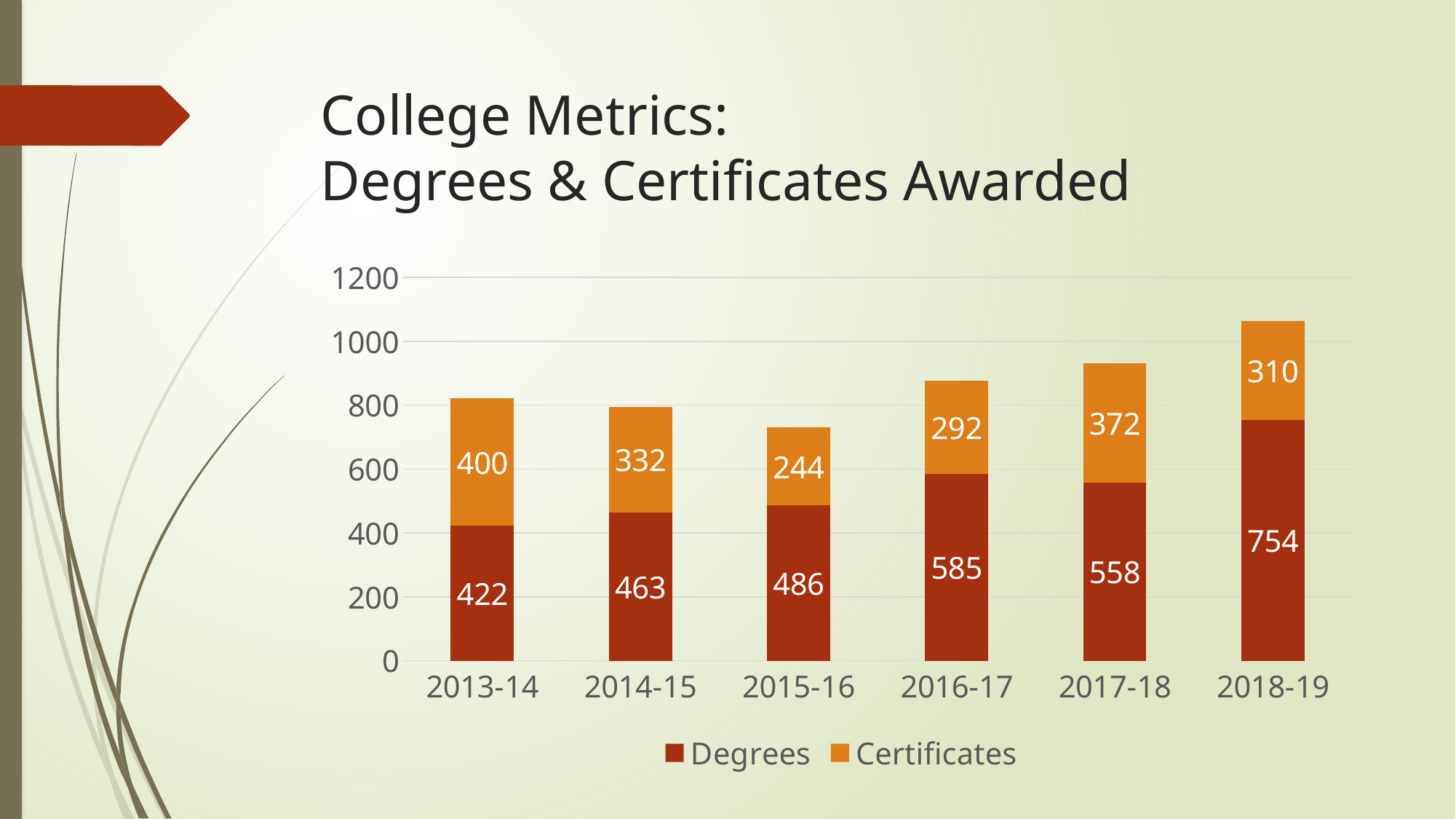
Were more Certificates awarded in 2013-14 or in 2017-18? 2013-14 Which year has the highest number of Degrees awarded? 2018-19 What is the difference between Degrees awarded in 2018-19 and 2017-18? 196 How many Degrees were awarded in 2018-19? 754 How many series does the legend list? 2 Which series is shown in the darker red colour? Degrees How many years are shown on the x axis? 6 How many Certificates were awarded in 2015-16? 244 What kind of chart is shown on the slide? Stacked bar chart Is the total height of the 2018-19 bar greater or less than 1000? greater What is the total of Degrees and Certificates awarded in 2016-17? 877 Which year has the lowest number of Certificates awarded? 2015-16